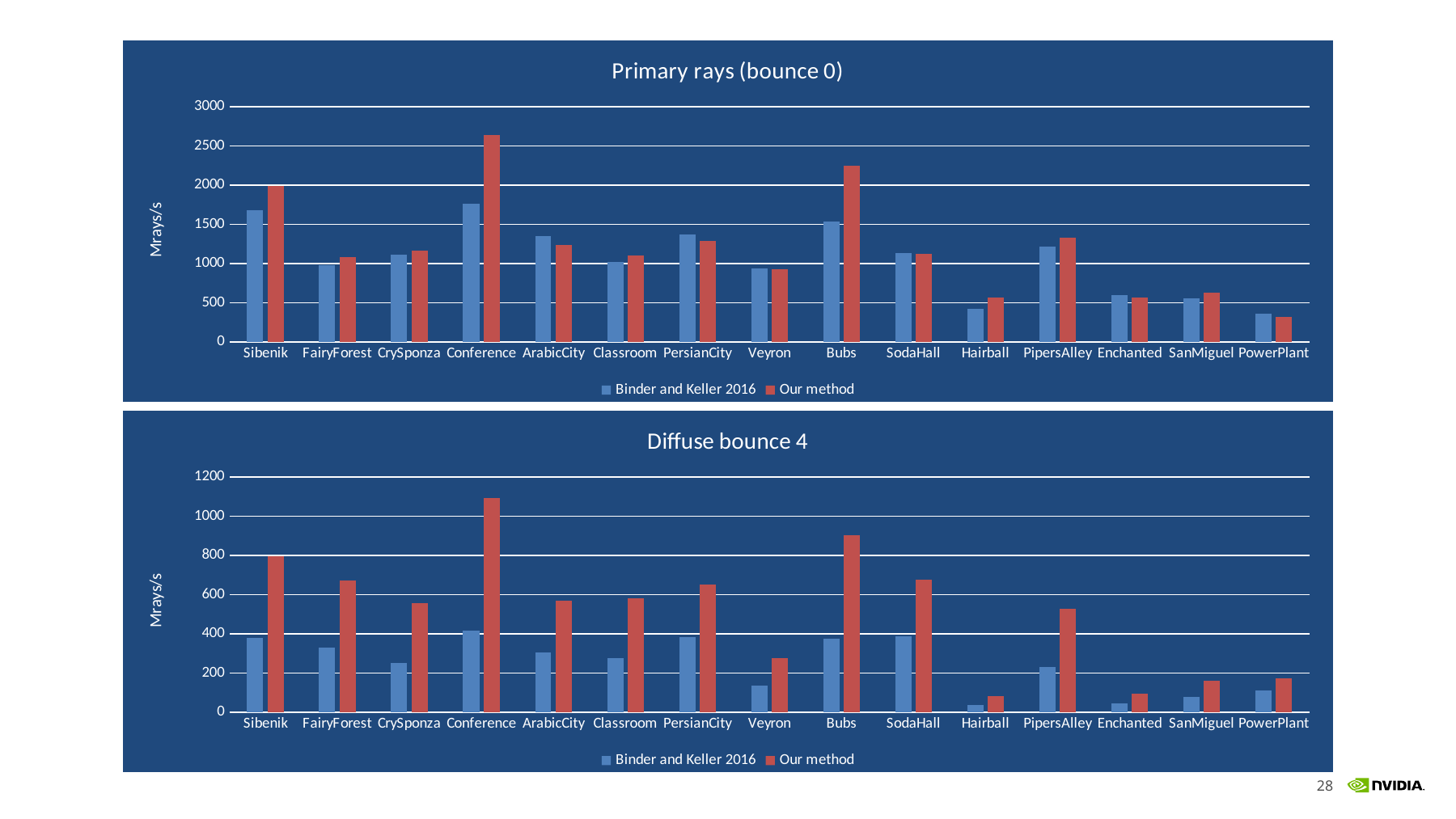
In the bottom chart "Diffuse bounce 4", is the value for Binder and Keller 2016 on Veyron greater or less than 200? less In the top chart "Primary rays (bounce 0)", which scene has the highest value for Our method? Conference In the bottom chart "Diffuse bounce 4", which scene has the highest value for Our method? Conference In the bottom chart "Diffuse bounce 4", which is larger for Bubs: Binder and Keller 2016 or Our method? Our method In the top chart "Primary rays (bounce 0)", how many scene categories are shown on the x axis? 15 In the bottom chart "Diffuse bounce 4", which scene has the lowest value for Binder and Keller 2016? Hairball What is the y-axis label of the bottom chart "Diffuse bounce 4"? Mrays/s In the top chart "Primary rays (bounce 0)", which scene has the lowest value for Our method? PowerPlant In the bottom chart "Diffuse bounce 4", how many series does the legend list? 2 In the top chart "Primary rays (bounce 0)", is the value for Our method on Bubs greater or less than 2000? greater What type of chart is the top chart titled "Primary rays (bounce 0)"? bar chart In the top chart "Primary rays (bounce 0)", is the value for Binder and Keller 2016 on Hairball greater or less than 500? less